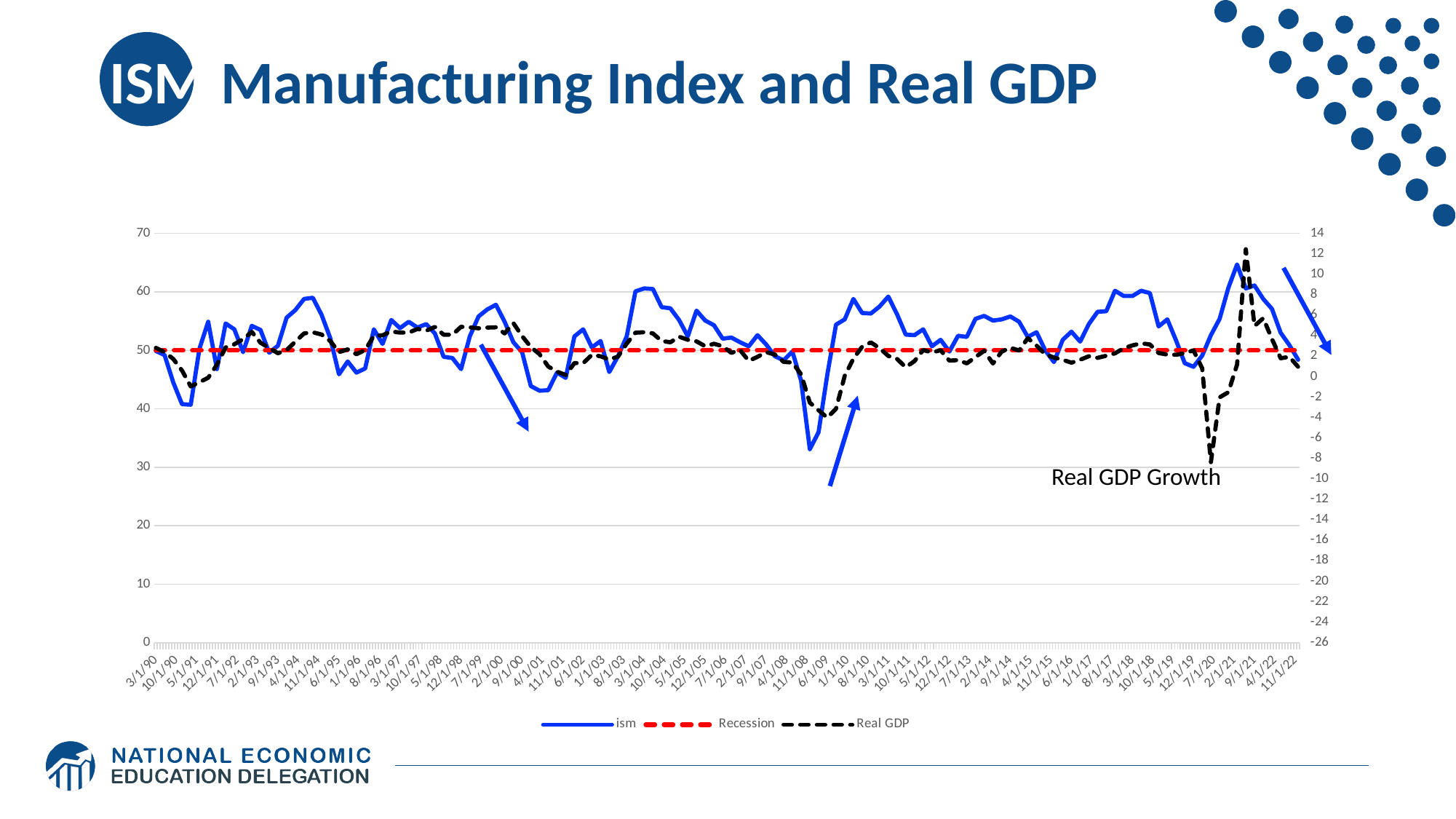
What kind of chart is shown on the slide? line chart What is the highest tick value shown on the left axis? 70 At what level on the left axis is the flat red dashed Recession line drawn? 50 What are the three series named in the legend? ism, Recession, Real GDP Is the highest value of the Real GDP series greater or less than 10 on the right axis? greater Is the Real GDP value at its sharp dip around 7/1/20 greater or less than 0 on the right axis? less Around which year does the ism series reach its lowest point? 2009 Is the ism value at its lowest point around 6/1/09 greater or less than 40? less How many series does the legend list? 3 Which ism trough is lower: the one around 2001 or the one around 2009? 2009 What is the title of the slide's chart? Manufacturing Index and Real GDP